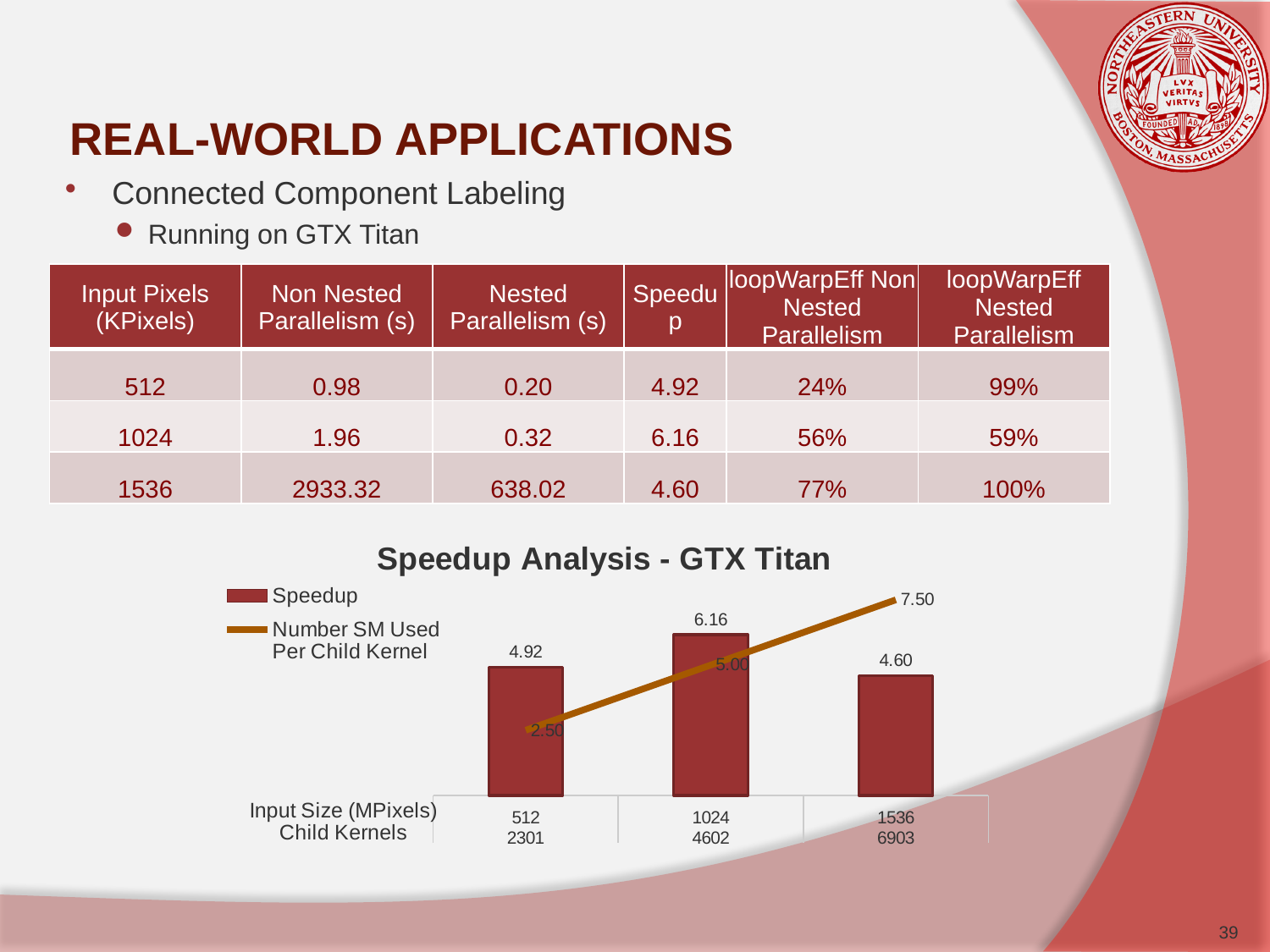
How many series does the chart's legend list? 2 What is the Speedup value for input size 1536 in the chart? 4.60 What is the title of the chart on the slide? Speedup Analysis - GTX Titan How many input size categories are plotted in the chart? 3 Which input size has the lowest Speedup in the chart? 1536 What is the Speedup value for input size 512 in the chart? 4.92 What is the Speedup value for input size 1024 in the chart? 6.16 What is the Number SM Used Per Child Kernel value for input size 1536 in the chart? 7.50 What is the Number SM Used Per Child Kernel value for input size 512 in the chart? 2.50 Which input size has the highest Speedup in the chart? 1024 Does the Number SM Used Per Child Kernel line rise or fall as input size increases along the x axis? rise What is the difference between the Speedup for input size 1024 and input size 512 in the chart? 1.24